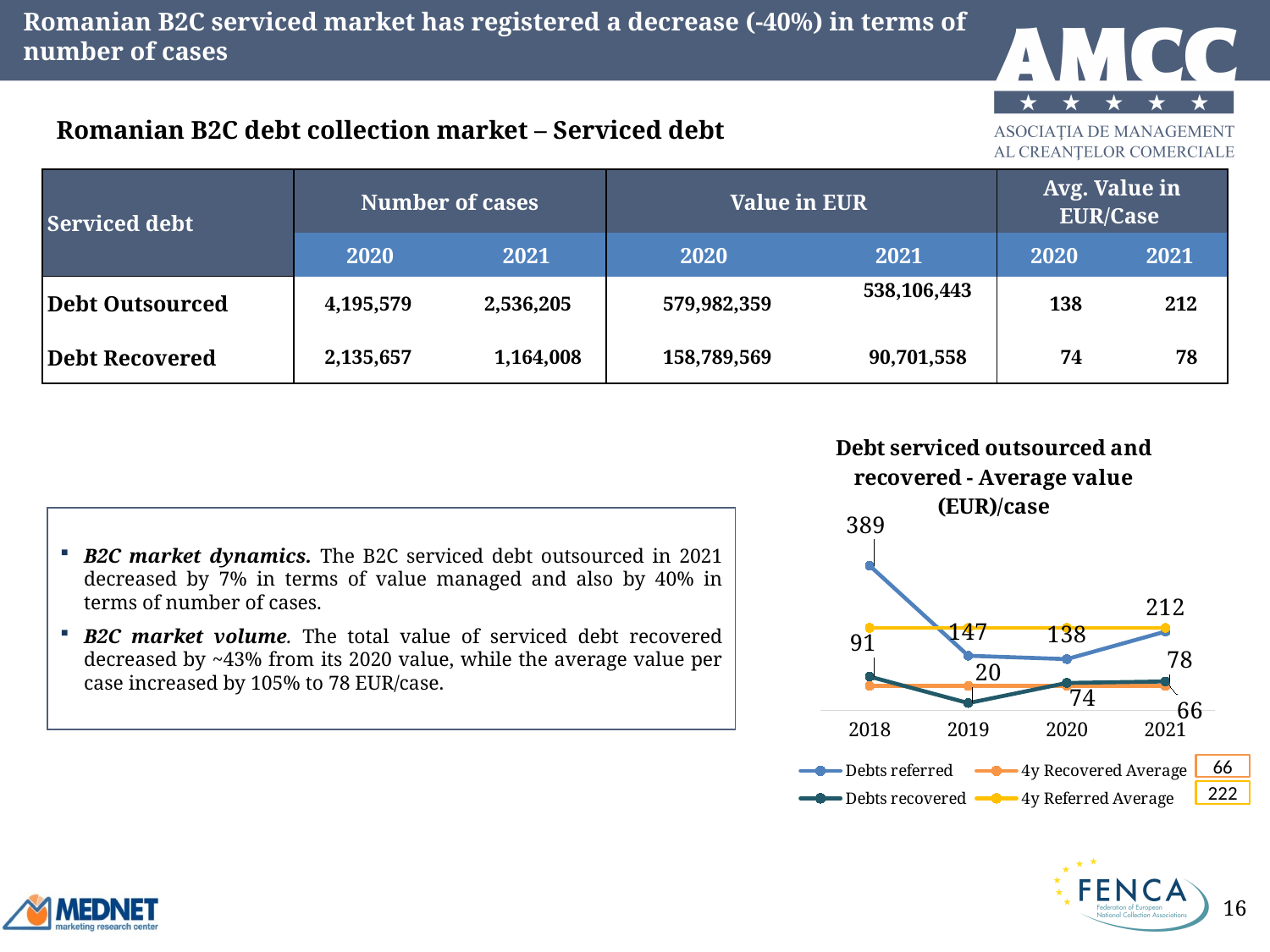
What is the value for Debts recovered in 2019? 20 How many series does the chart legend list? 4 What is the value for Debts referred in 2018? 389 Does the Debts referred line rise or fall from 2018 to 2019? fall How many years are shown on the x axis of the chart? 4 What is the difference between Debts referred and Debts recovered in 2021? 134 Which is larger in 2020: Debts referred or Debts recovered? Debts referred What is the value for Debts recovered in 2020? 74 What kind of chart is shown on the slide? line chart What is the value for Debts referred in 2021? 212 In which year is the Debts referred value highest? 2018 In which year is the Debts recovered value lowest? 2019